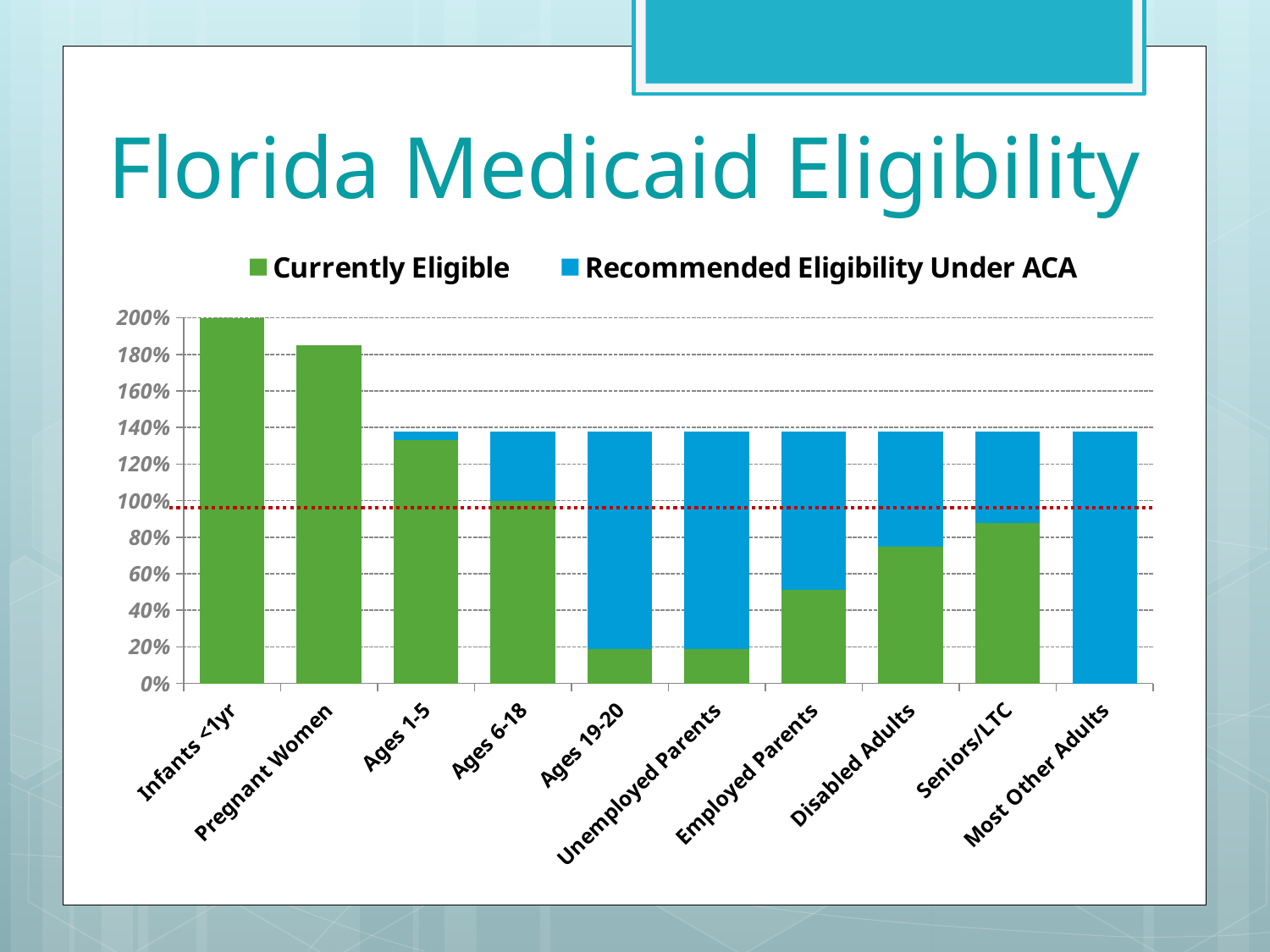
What kind of chart is shown on the slide? Bar chart Is the Currently Eligible value for Ages 19-20 greater or less than 40%? less Which has the larger Currently Eligible value, Pregnant Women or Ages 1-5? Pregnant Women Is the Currently Eligible value for Pregnant Women greater or less than 160%? greater Which category has the highest Currently Eligible value? Infants <1yr Is the Currently Eligible value for Employed Parents greater or less than 60%? less Which category has the lowest Currently Eligible value? Most Other Adults How many categories are shown on the x axis? 10 Which has the larger Currently Eligible value, Seniors/LTC or Disabled Adults? Seniors/LTC What is the title of the slide containing the chart? Florida Medicaid Eligibility How many series does the legend list? 2